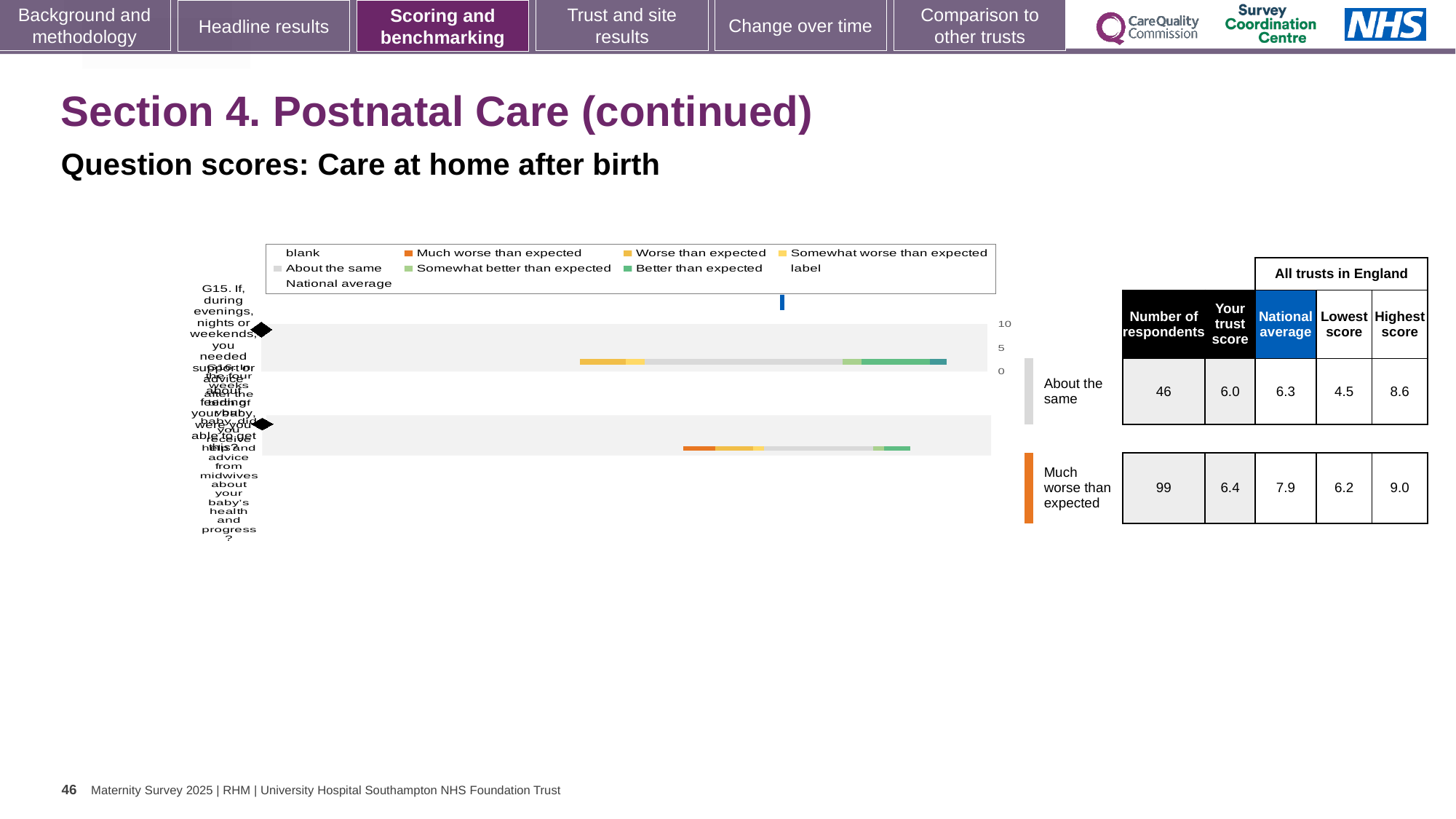
For the row labelled 'About the same', which is larger: the trust score or the national average? national average What colour is used in the legend for 'About the same'? grey In the table, what is 'Your trust score' for the row labelled 'Much worse than expected'? 6.4 In the table, what is the lowest score for the row labelled 'About the same'? 4.5 How many question rows (bars) does the chart show? 2 For the row labelled 'Much worse than expected', what is the difference between the national average and the trust score? 1.5 Which row in the table has more respondents, 'About the same' or 'Much worse than expected'? Much worse than expected What colour is used in the legend for 'Much worse than expected'? orange What kind of chart is shown on the slide? bar chart In the table, what is the number of respondents for the row labelled 'About the same'? 46 In the table, what is the national average for the row labelled 'About the same'? 6.3 In the table, what is the highest score for the row labelled 'Much worse than expected'? 9.0